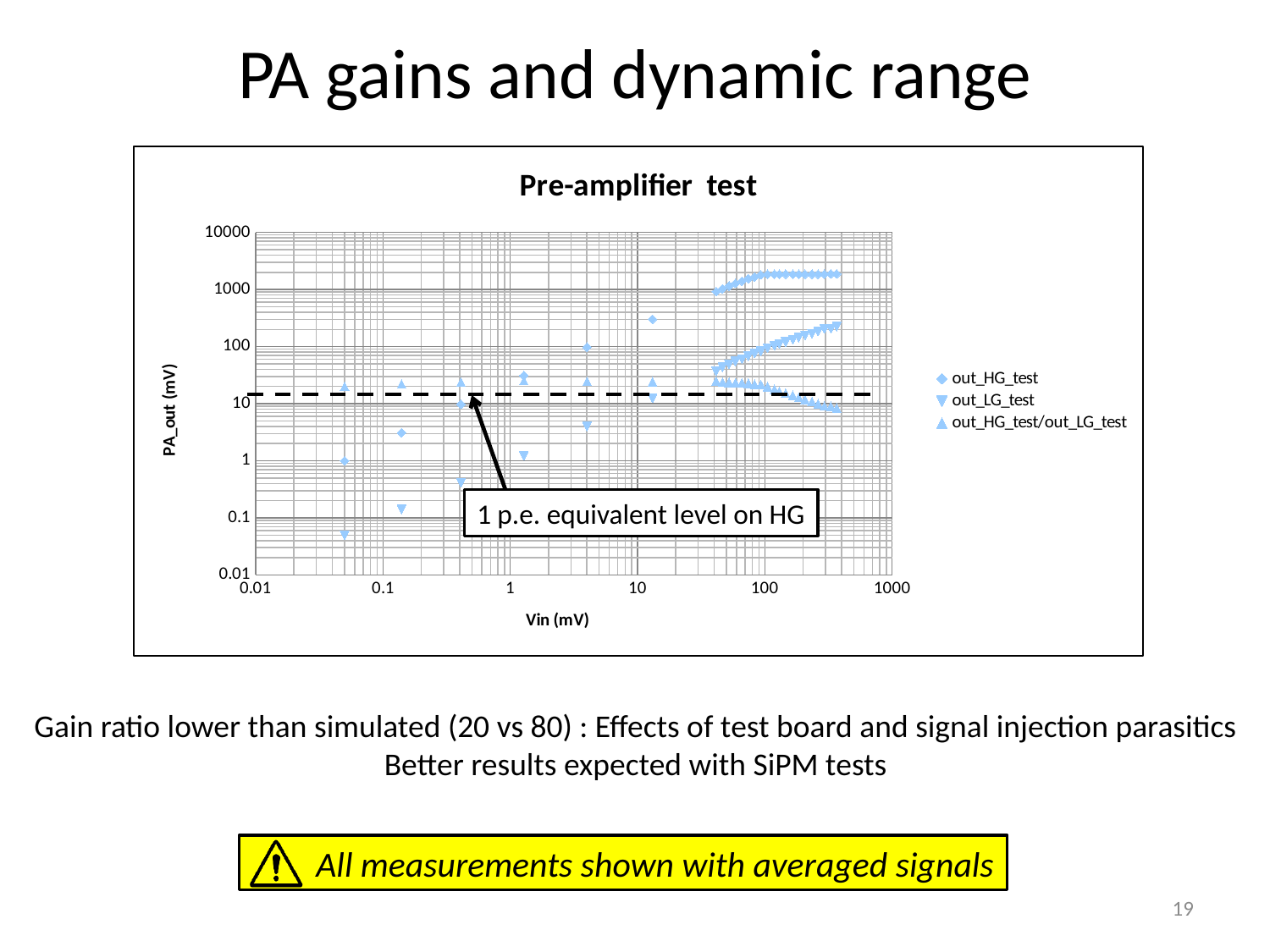
What is the title of the chart? Pre-amplifier test Does the out_HG_test/out_LG_test series rise or fall as Vin increases from 100 to 400 mV? fall Is the value of out_LG_test at Vin = 0.05 mV greater or less than 0.1? less How many series does the chart legend list? 3 Is the value of out_LG_test at Vin = 300 mV greater or less than 1000? less Does the out_HG_test series rise or fall as Vin increases from 0.1 to 100 mV? rise What is the label of the x axis of the chart? Vin (mV) Which series in the chart reaches the highest PA_out values? out_HG_test What kind of chart is shown on the slide? scatter chart At Vin = 100 mV, which series has the larger value, out_HG_test or out_LG_test? out_HG_test Is the value of out_HG_test at Vin = 100 mV greater or less than 1000? greater